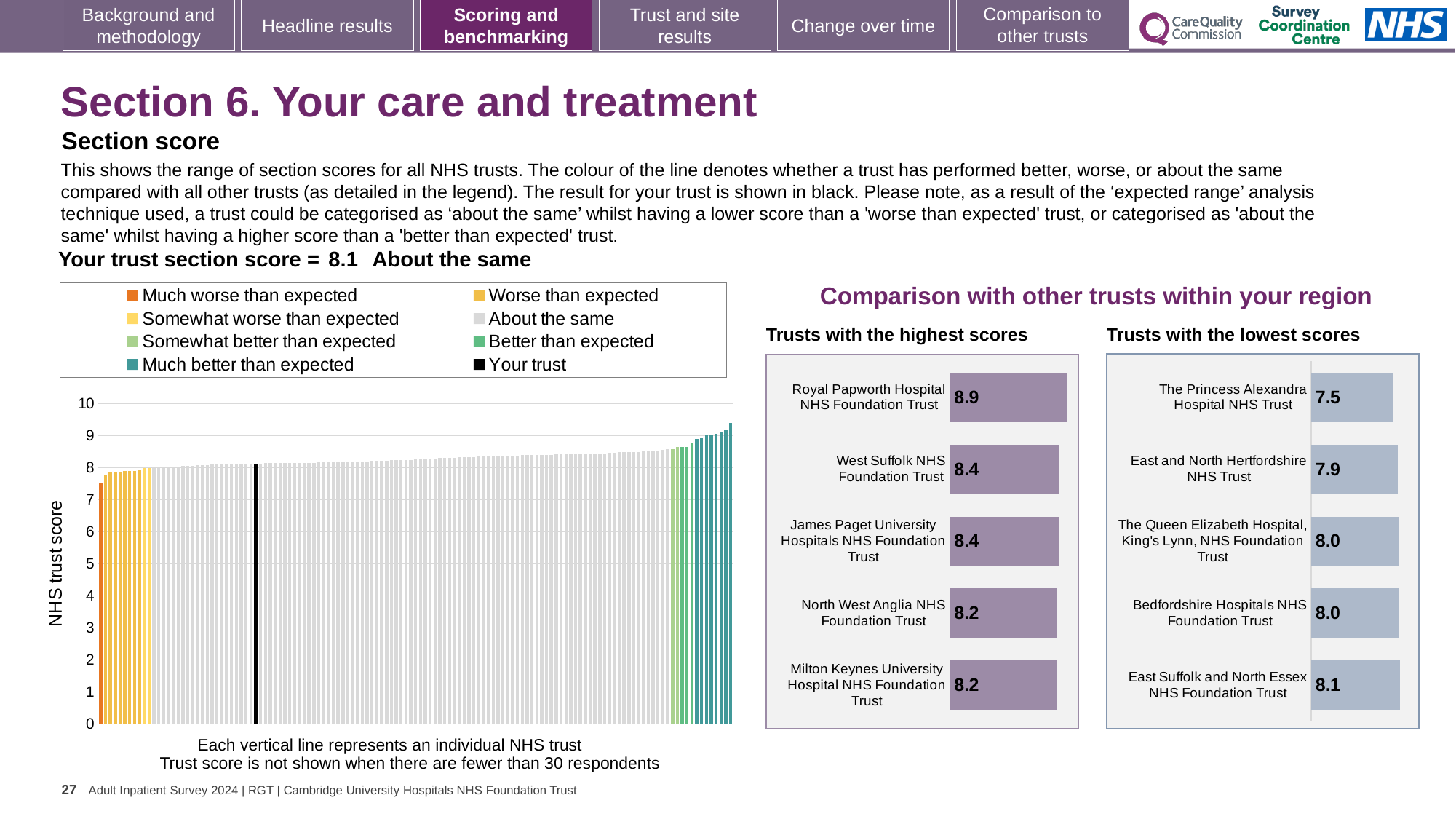
In the left-hand NHS trust score chart, is the value of the tallest bar greater or less than 9? greater In the 'Trusts with the highest scores' chart, what is the difference between the scores of Royal Papworth Hospital NHS Foundation Trust and North West Anglia NHS Foundation Trust? 0.7 In the 'Trusts with the lowest scores' chart, which trust has the lowest score? The Princess Alexandra Hospital NHS Trust How many entries does the legend of the left-hand NHS trust score chart list? 8 In the 'Trusts with the highest scores' chart, which trust has the highest score? Royal Papworth Hospital NHS Foundation Trust In the 'Trusts with the highest scores' chart, what is the score for Royal Papworth Hospital NHS Foundation Trust? 8.9 In the left-hand NHS trust score chart, do the values rise or fall from left to right along the x axis? Rise In the 'Trusts with the lowest scores' chart, which has the larger score: East and North Hertfordshire NHS Trust or Bedfordshire Hospitals NHS Foundation Trust? Bedfordshire Hospitals NHS Foundation Trust What kind of chart is the large chart on the left showing NHS trust scores? Bar chart In the 'Trusts with the lowest scores' chart, what is the score for The Princess Alexandra Hospital NHS Trust? 7.5 In the 'Trusts with the lowest scores' chart, what is the difference between the scores of East Suffolk and North Essex NHS Foundation Trust and The Princess Alexandra Hospital NHS Trust? 0.6 How many trusts are shown in the 'Trusts with the highest scores' chart? 5